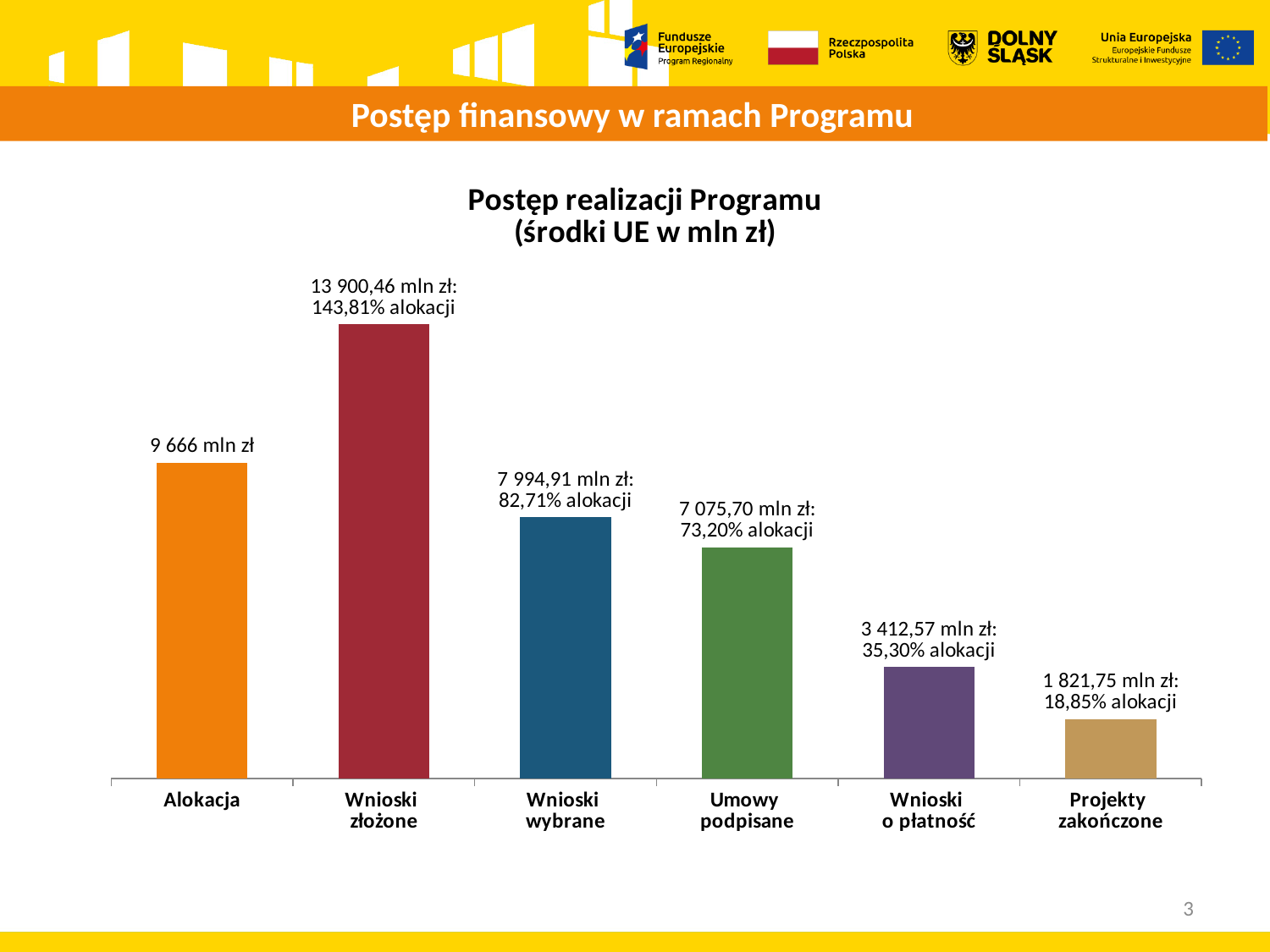
Which category has the lowest value? Projekty zakończone Which category has the highest value? Wnioski złożone What is the value shown for Projekty zakończone? 1 821,75 mln zł What is the difference between Wnioski złożone and Alokacja in mln zł? 4 234,46 mln zł How many categories are shown on the x axis of the chart? 6 What type of chart is shown on the slide? Bar chart What is the title of the chart? Postęp realizacji Programu (środki UE w mln zł) Which is larger, Wnioski o płatność or Projekty zakończone? Wnioski o płatność What is the difference between Wnioski wybrane and Umowy podpisane in mln zł? 919,21 mln zł What percentage of the allocation do Umowy podpisane represent? 73,20% alokacji What is the value shown for Wnioski złożone? 13 900,46 mln zł What is the value shown for Alokacja? 9 666 mln zł